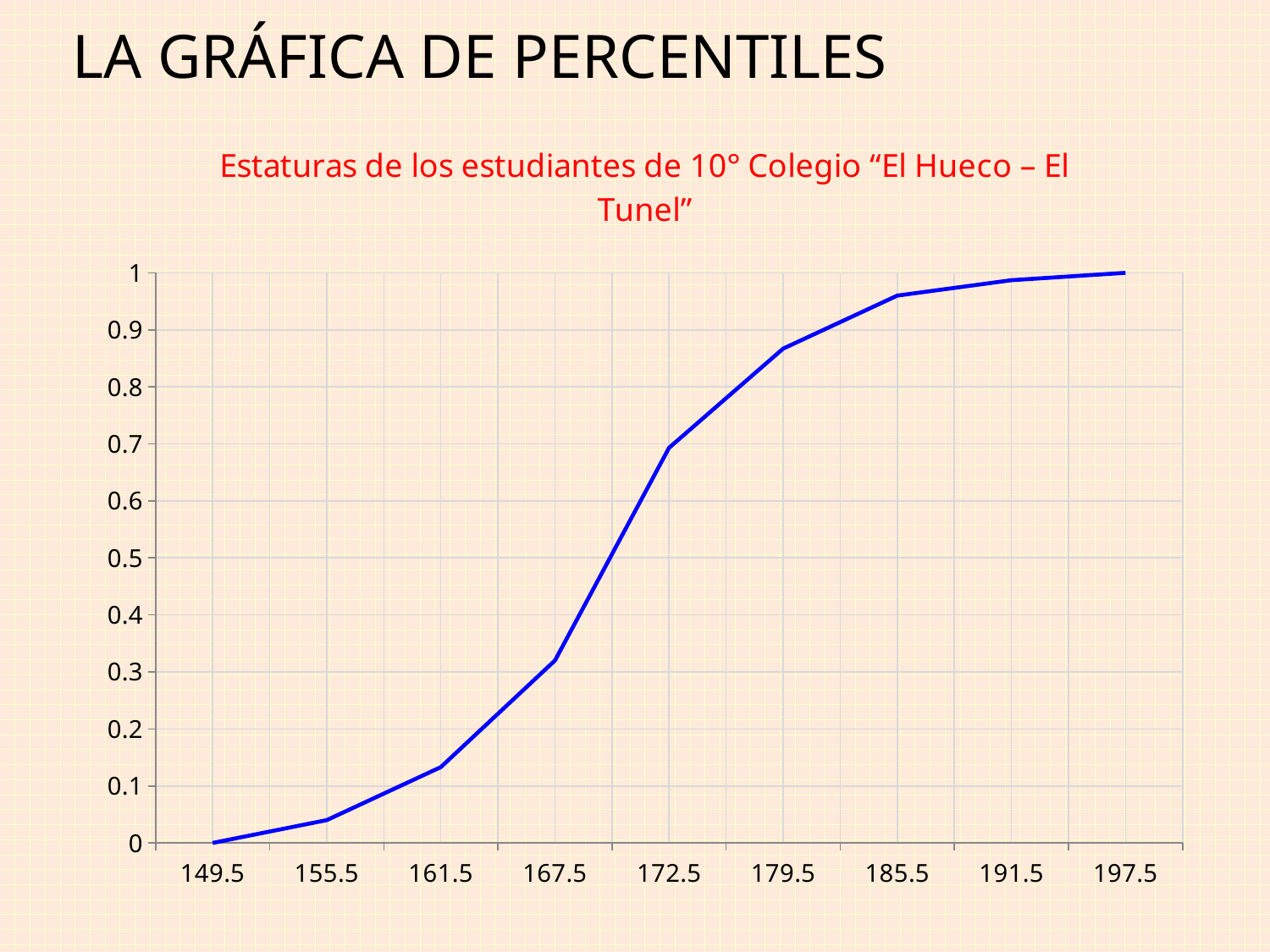
Which is larger, the value at 161.5 or the value at 185.5? 185.5 What kind of chart is shown on the slide? line chart What is the title of the chart? Estaturas de los estudiantes de 10° Colegio "El Hueco – El Tunel" What is the value at 197.5? 1 Do the values rise or fall as the x axis goes from 149.5 to 197.5? rise Is the value at 167.5 greater or less than 0.4? less What is the value at 149.5? 0 Which x value has the highest plotted value? 197.5 Is the value at 179.5 greater or less than 0.8? greater How many points are plotted along the x axis? 9 Which x value has the lowest plotted value? 149.5 Is the value at 172.5 greater or less than 0.6? greater